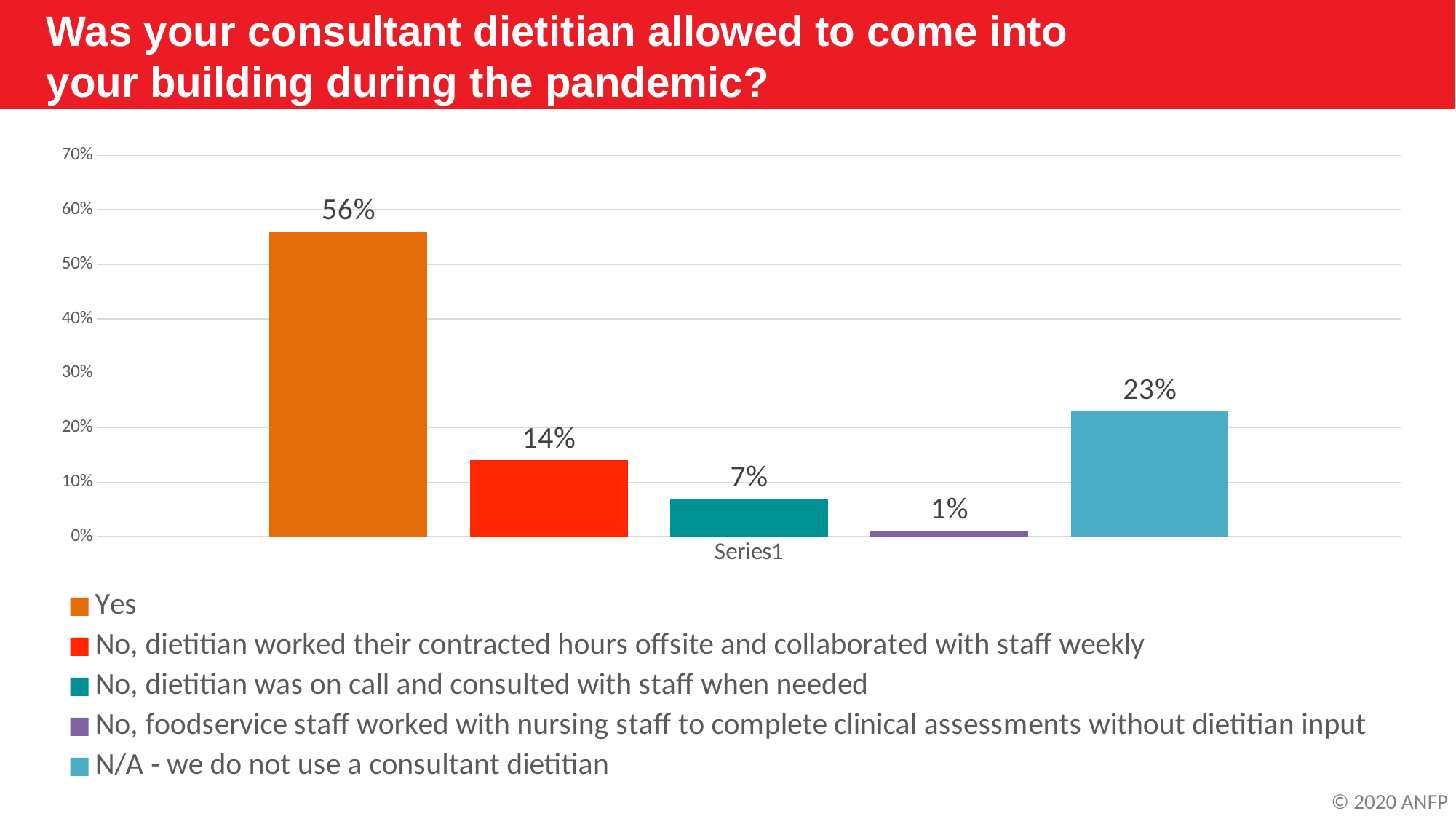
What percentage of respondents said foodservice staff worked with nursing staff to complete clinical assessments without dietitian input? 1% Which response has the lowest percentage? No, foodservice staff worked with nursing staff to complete clinical assessments without dietitian input What percentage of respondents answered "N/A - we do not use a consultant dietitian"? 23% What is the highest value shown on the vertical axis? 70% Which is larger: the percentage for "No, dietitian worked their contracted hours offsite and collaborated with staff weekly" or for "No, dietitian was on call and consulted with staff when needed"? No, dietitian worked their contracted hours offsite and collaborated with staff weekly Which response has the highest percentage? Yes What percentage of respondents answered "Yes"? 56% What percentage of respondents said the dietitian was on call and consulted with staff when needed? 7% What colour is the bar for "Yes"? Orange How many response categories are shown in the chart? 5 What is the difference in percentage points between "Yes" and "N/A - we do not use a consultant dietitian"? 33 What type of chart is shown on the slide? Bar chart